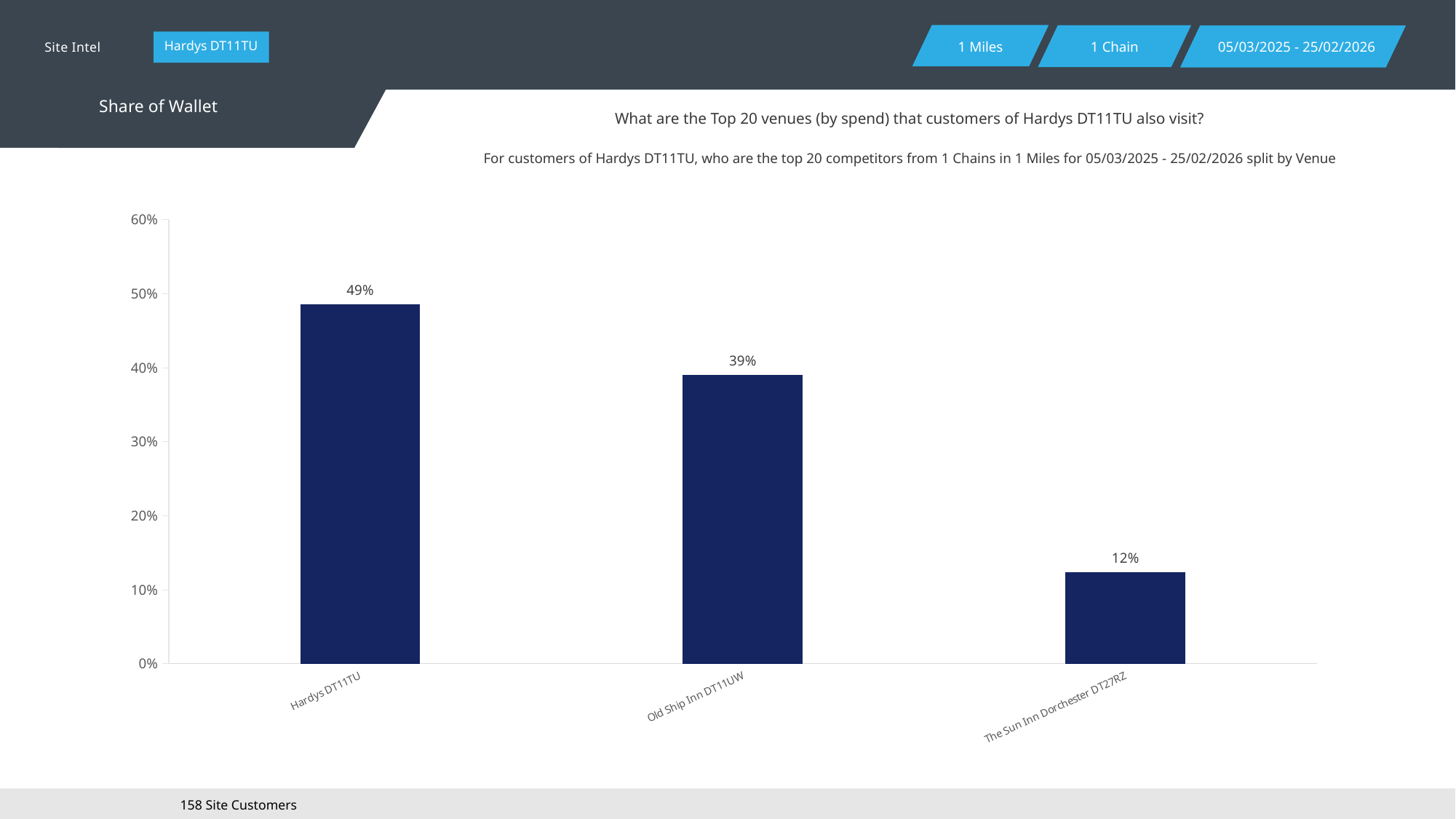
What kind of chart is shown on the slide? bar chart Which is larger, the value for Old Ship Inn DT11UW or The Sun Inn Dorchester DT27RZ? Old Ship Inn DT11UW What is the value for Old Ship Inn DT11UW? 39% Do the values rise or fall from left to right along the x axis? fall Which venue has the highest value? Hardys DT11TU What is the value for The Sun Inn Dorchester DT27RZ? 12% What is the difference between the values for Hardys DT11TU and Old Ship Inn DT11UW? 10% Which venue has the lowest value? The Sun Inn Dorchester DT27RZ Is the value for Old Ship Inn DT11UW greater or less than 40%? less What is the difference between the values for Old Ship Inn DT11UW and The Sun Inn Dorchester DT27RZ? 27% What is the value for Hardys DT11TU? 49% How many venues are shown on the chart? 3